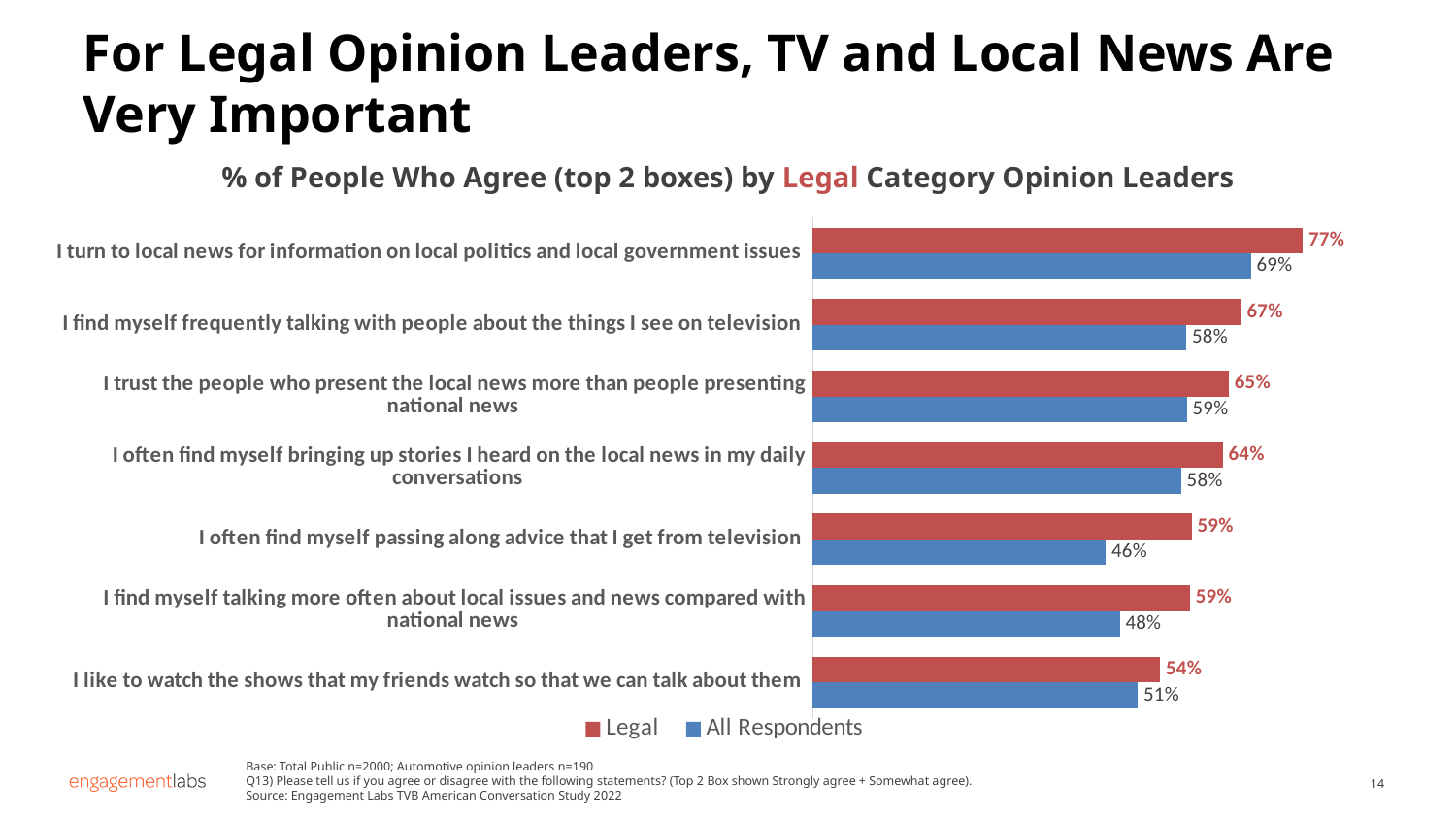
How many series does the legend list? 2 What is the difference between the Legal and All Respondents values for "I find myself frequently talking with people about the things I see on television"? 9 percentage points What type of chart is shown on the slide? Bar chart Which statement has the lowest All Respondents value? I often find myself passing along advice that I get from television How many statements are shown in the chart? 7 Which is larger: the Legal value for "I trust the people who present the local news more than people presenting national news" or the All Respondents value for "I turn to local news for information on local politics and local government issues"? All Respondents value for "I turn to local news for information on local politics and local government issues" (69%) What is the difference between the Legal and All Respondents values for "I often find myself passing along advice that I get from television"? 13 percentage points What is the Legal value for "I like to watch the shows that my friends watch so that we can talk about them"? 54% What percentage of Legal opinion leaders agree with "I turn to local news for information on local politics and local government issues"? 77% Which statement has the highest Legal value? I turn to local news for information on local politics and local government issues Which colour represents the Legal series in the chart? Red What is the All Respondents value for "I often find myself passing along advice that I get from television"? 46%